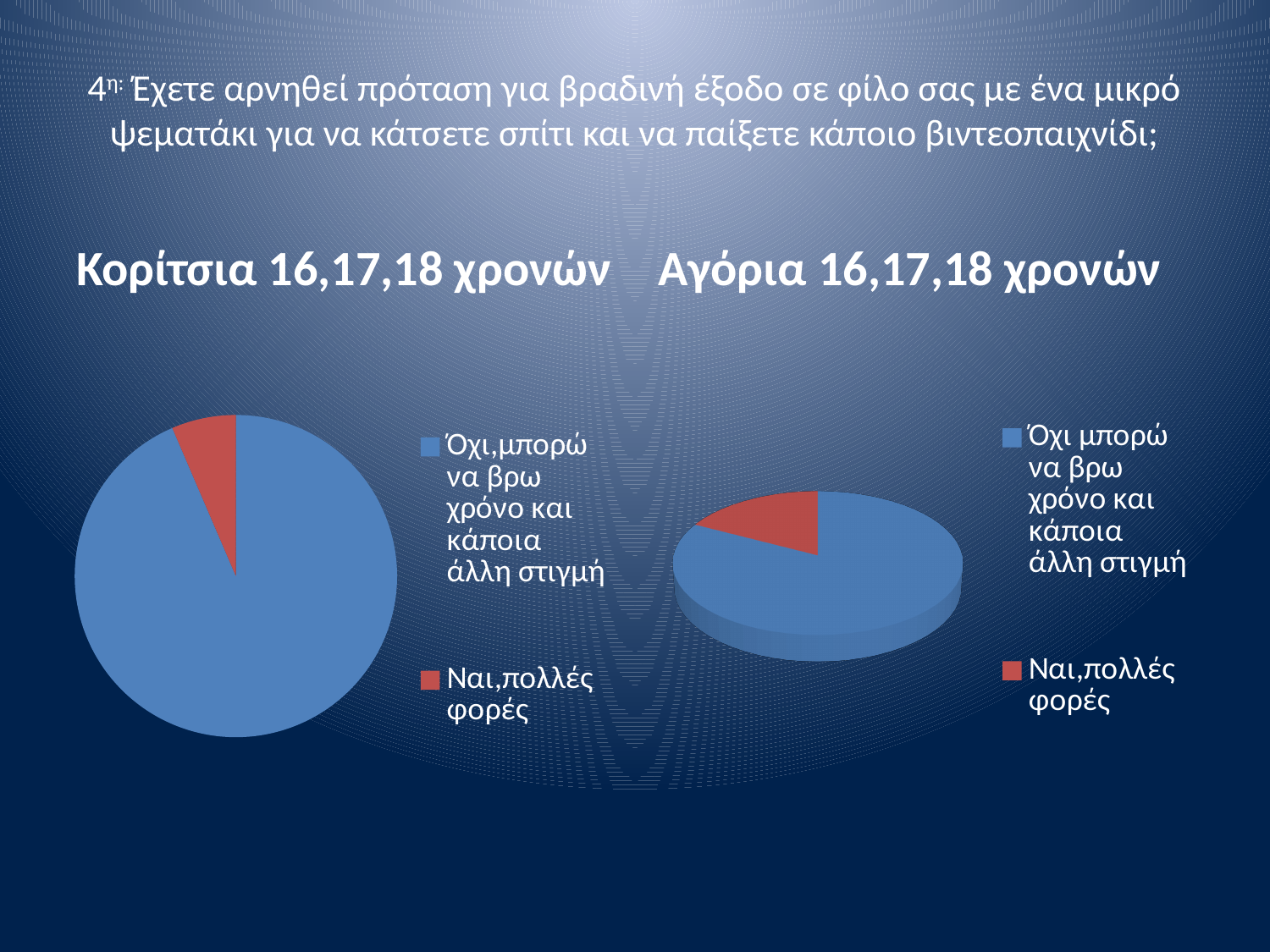
In the chart titled "Αγόρια 16,17,18 χρονών", which category has the smallest slice? Ναι,πολλές φορές In the chart titled "Κορίτσια 16,17,18 χρονών", how many slices does the pie have? 2 In the chart titled "Κορίτσια 16,17,18 χρονών", how many entries does the legend list? 2 What kind of chart is the chart titled "Κορίτσια 16,17,18 χρονών"? Pie chart In the chart titled "Κορίτσια 16,17,18 χρονών", what colour is the slice for "Ναι,πολλές φορές"? Red What kind of chart is the chart titled "Αγόρια 16,17,18 χρονών"? Pie chart In the chart titled "Κορίτσια 16,17,18 χρονών", which category has the smallest slice? Ναι,πολλές φορές In the chart titled "Αγόρια 16,17,18 χρονών", which slice is larger: "Όχι μπορώ να βρω χρόνο και κάποια άλλη στιγμή" or "Ναι,πολλές φορές"? Όχι μπορώ να βρω χρόνο και κάποια άλλη στιγμή What is the title of the chart on the right side of the slide? Αγόρια 16,17,18 χρονών In the chart titled "Κορίτσια 16,17,18 χρονών", which category has the largest slice? Όχι,μπορώ να βρω χρόνο και κάποια άλλη στιγμή In the chart titled "Αγόρια 16,17,18 χρονών", how many slices does the pie have? 2 In the chart titled "Αγόρια 16,17,18 χρονών", which category has the largest slice? Όχι μπορώ να βρω χρόνο και κάποια άλλη στιγμή